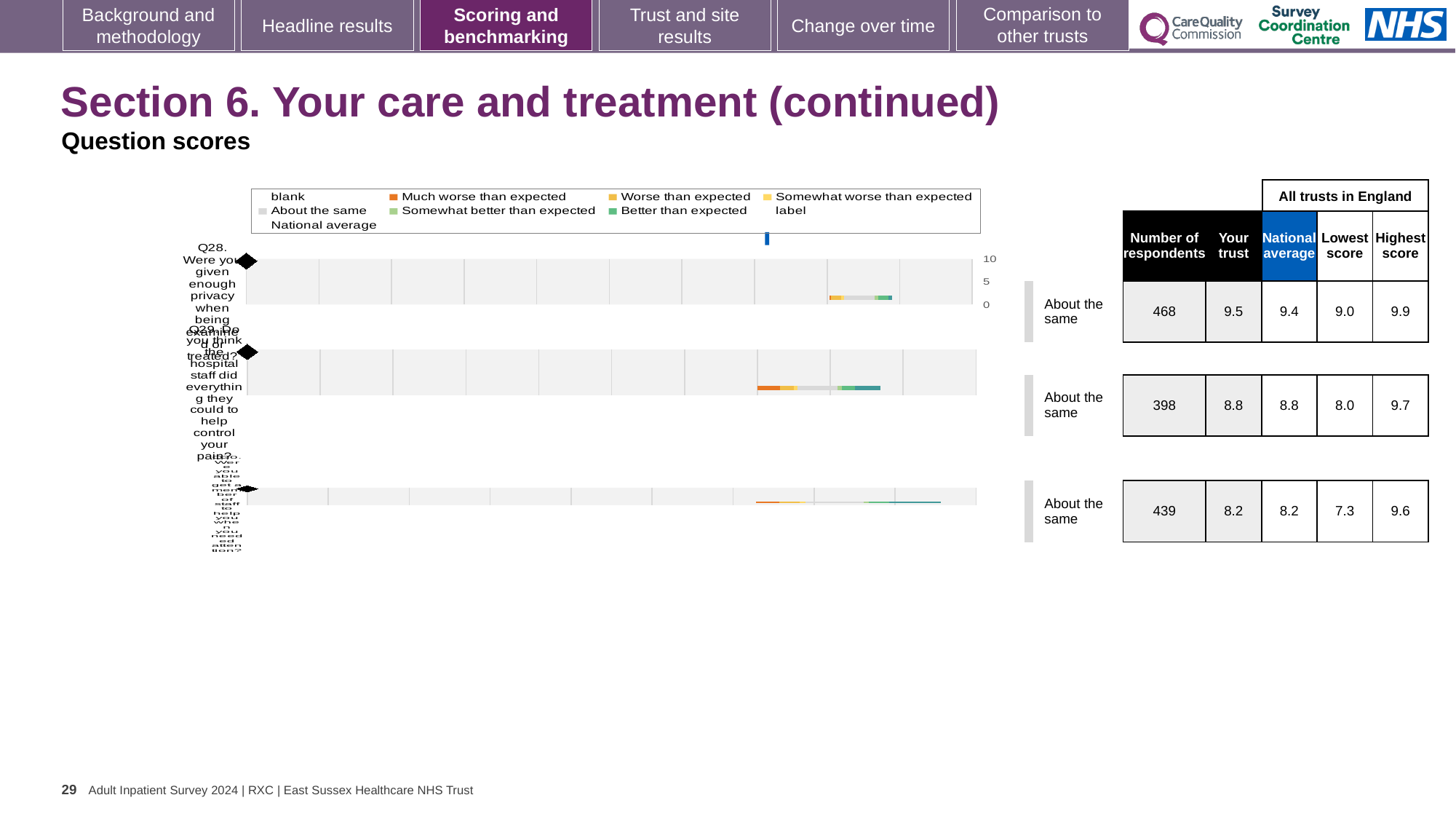
According to the table beside the Q29 chart, what is the 'Your trust' score for Q29? 8.8 According to the table beside the Q28 chart, what is the lowest score among all trusts in England for Q28? 9.0 According to the table beside the Q28 chart, how many respondents answered Q28? 468 According to the table beside the Q30 chart, what is the national average for Q30? 8.2 For Q28, which is larger: the 'Your trust' score or the national average? Your trust What benchmark category label is shown next to each of the three question charts? About the same Which of the three questions has the highest 'Your trust' score? Q28 How many questions (Q28, Q29, Q30) are plotted on the slide? 3 What is the highest value shown on the score axis of the Q28 chart? 10 Which of the three questions has the lowest number of respondents? Q29 What kind of chart is used to show the question scores on this slide? bar chart For Q30, what is the difference between the highest score (9.6) and the lowest score (7.3) among all trusts in England? 2.3